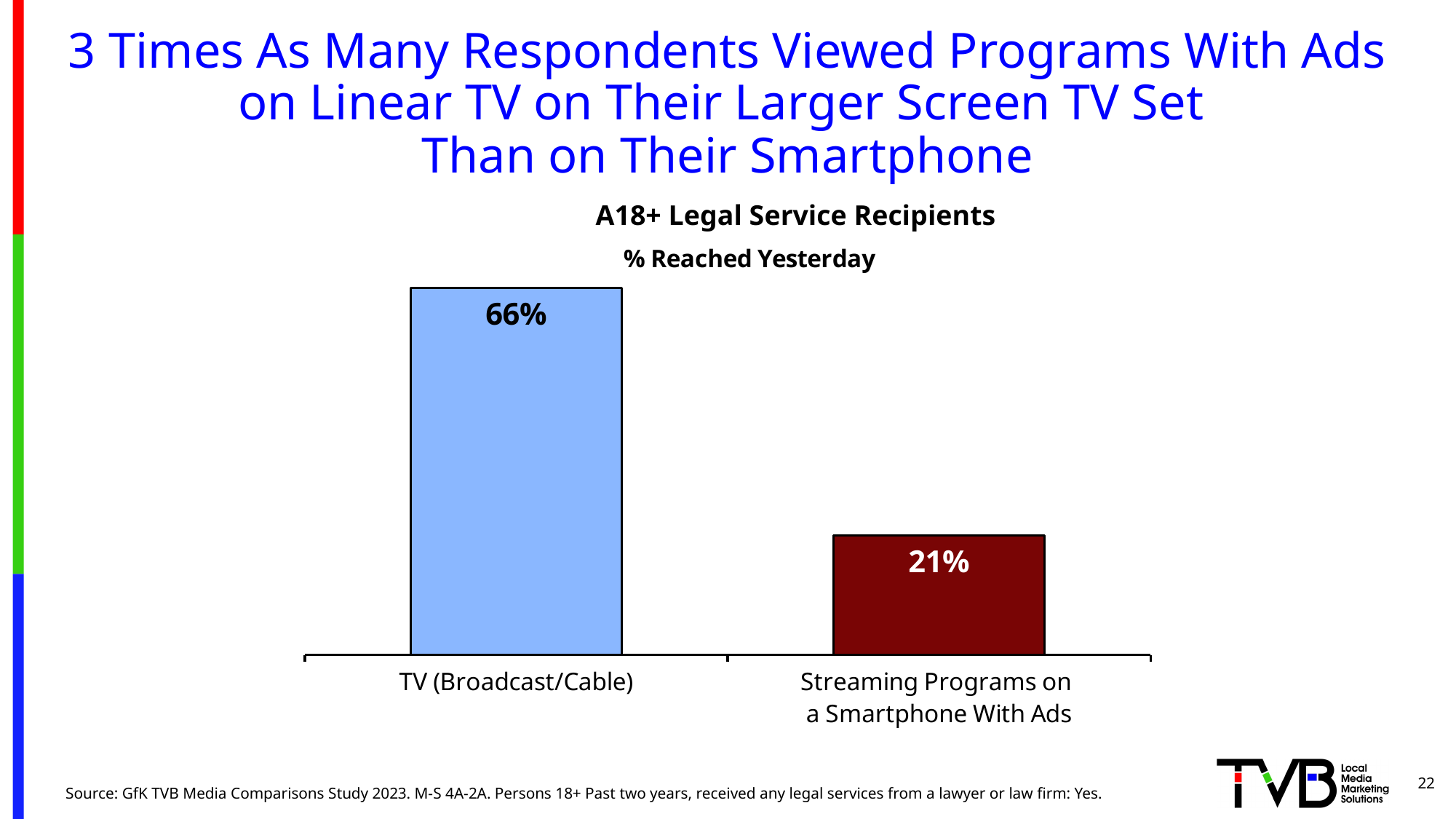
Do the values rise or fall from left to right across the categories? Fall What is the chart's title? % Reached Yesterday What is the difference in percentage points between TV (Broadcast/Cable) and Streaming Programs on a Smartphone With Ads? 45 percentage points Which is larger: the value for TV (Broadcast/Cable) or the value for Streaming Programs on a Smartphone With Ads? TV (Broadcast/Cable) Which category has the lowest % Reached Yesterday? Streaming Programs on a Smartphone With Ads What is the % Reached Yesterday value for Streaming Programs on a Smartphone With Ads? 21% What kind of chart is shown on the slide? Bar chart What is the % Reached Yesterday value for TV (Broadcast/Cable)? 66% What is the subtitle of the chart describing the measure plotted? % Reached Yesterday Which category has the highest % Reached Yesterday? TV (Broadcast/Cable) How many categories are shown in the chart? 2